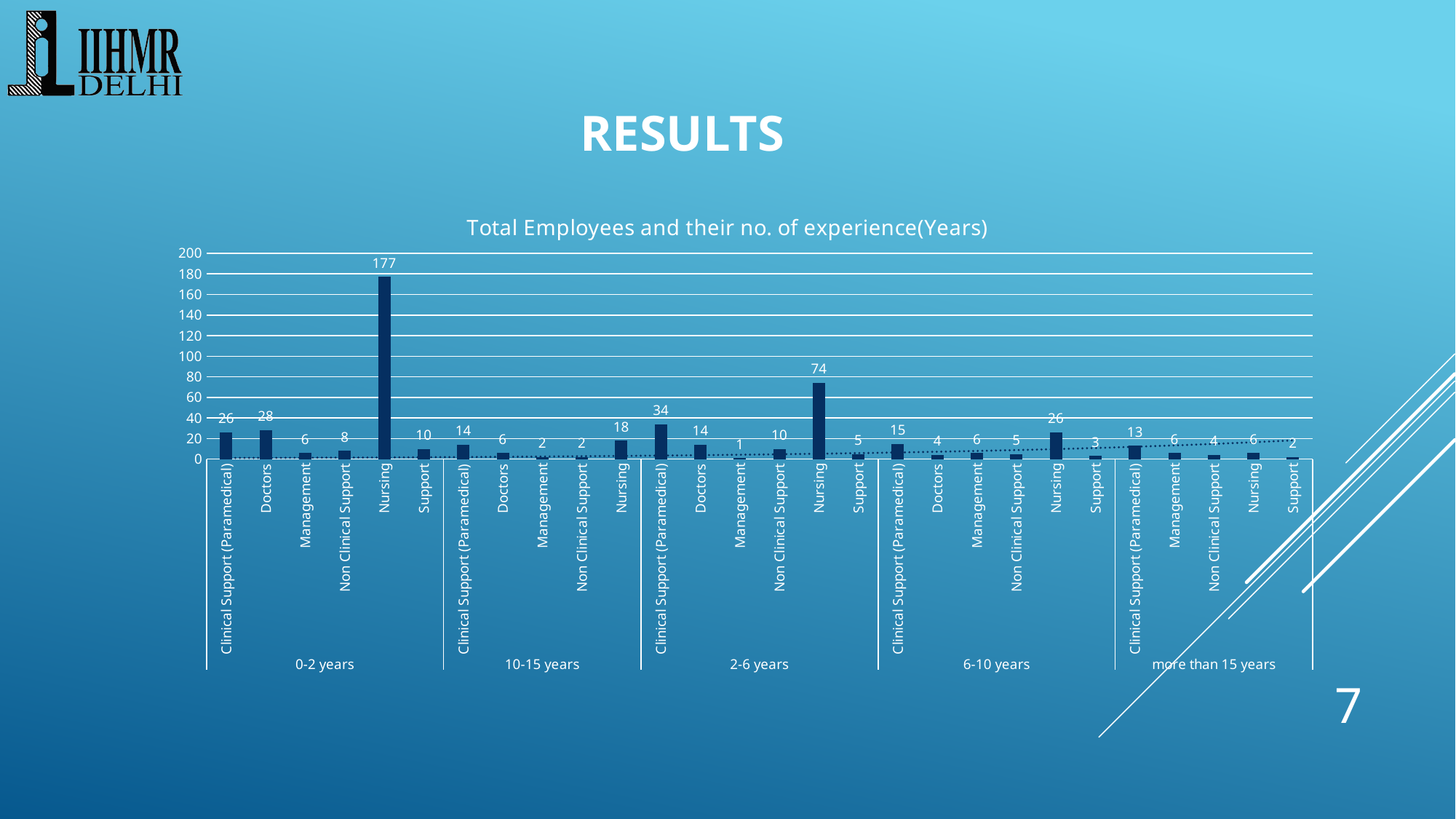
Which category has the lowest value in the 2-6 years group? Management How many experience groups are shown on the x axis? 5 What is the value for Doctors in the 6-10 years group? 4 What is the value for Nursing in the 0-2 years group? 177 What is the value for Nursing in the more than 15 years group? 6 What is the value for Clinical Support (Paramedical) in the 2-6 years group? 34 What is the difference between Nursing in the 0-2 years group and Nursing in the 2-6 years group? 103 Which bar has the highest value in the chart? Nursing (0-2 years) Which is larger: Doctors in the 0-2 years group or Doctors in the 2-6 years group? Doctors in the 0-2 years group What is the difference between Clinical Support (Paramedical) and Doctors in the 10-15 years group? 8 What kind of chart is shown on the slide? Bar chart What is the title of the chart? Total Employees and their no. of experience(Years)